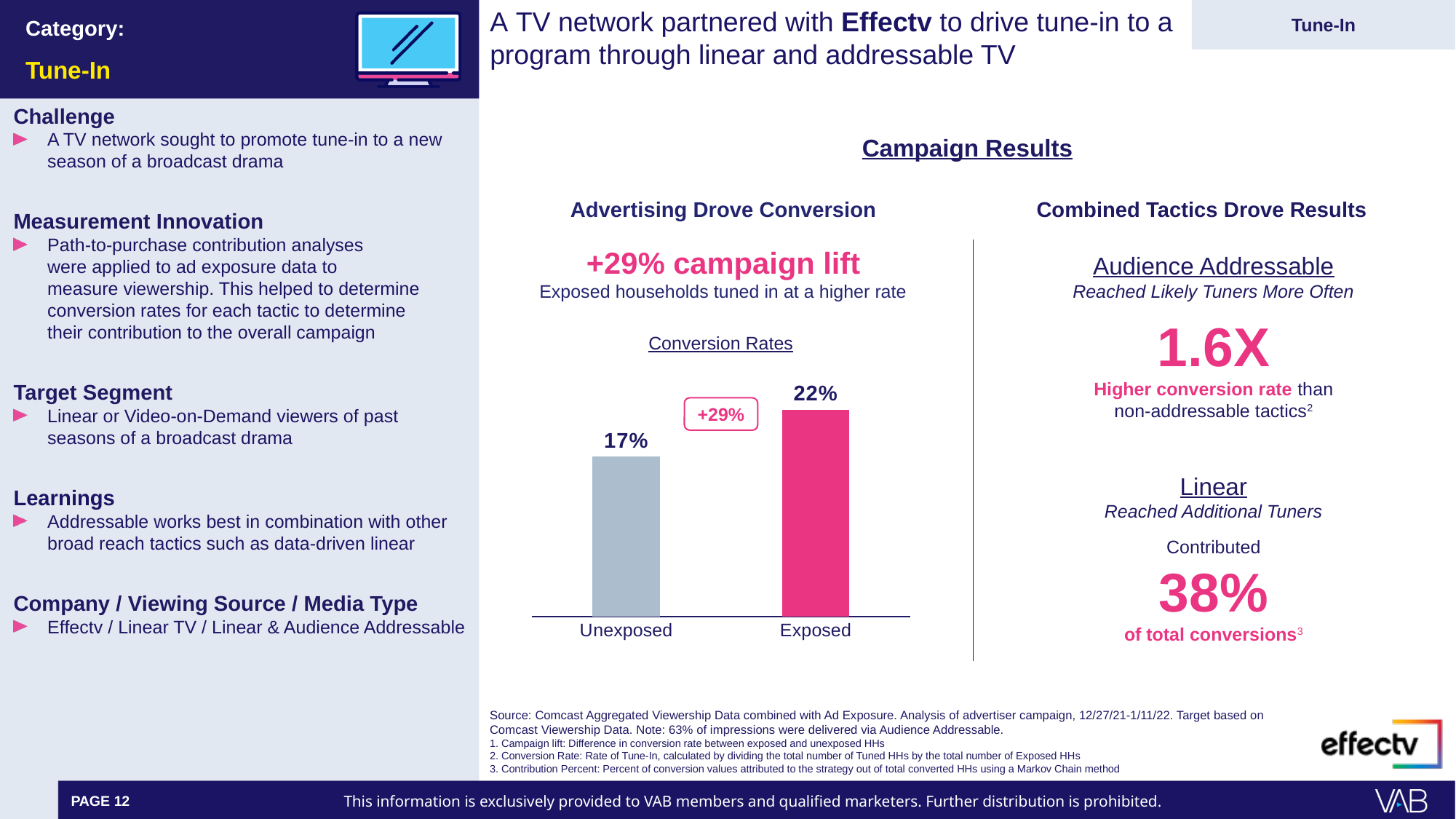
What is the conversion rate for Unexposed households in the Conversion Rates chart? 17% What is the title of the chart on the slide? Conversion Rates Is the conversion rate for Exposed larger or smaller than the rate for Unexposed? larger What lift percentage is shown in the callout between the two bars of the Conversion Rates chart? +29% What is the conversion rate for Exposed households in the Conversion Rates chart? 22% Which category has the lower conversion rate in the Conversion Rates chart? Unexposed What is the difference in percentage points between the Exposed and Unexposed conversion rates? 5 percentage points What kind of chart is the Conversion Rates chart? bar chart How many categories are shown in the Conversion Rates chart? 2 Which category has the higher conversion rate in the Conversion Rates chart? Exposed